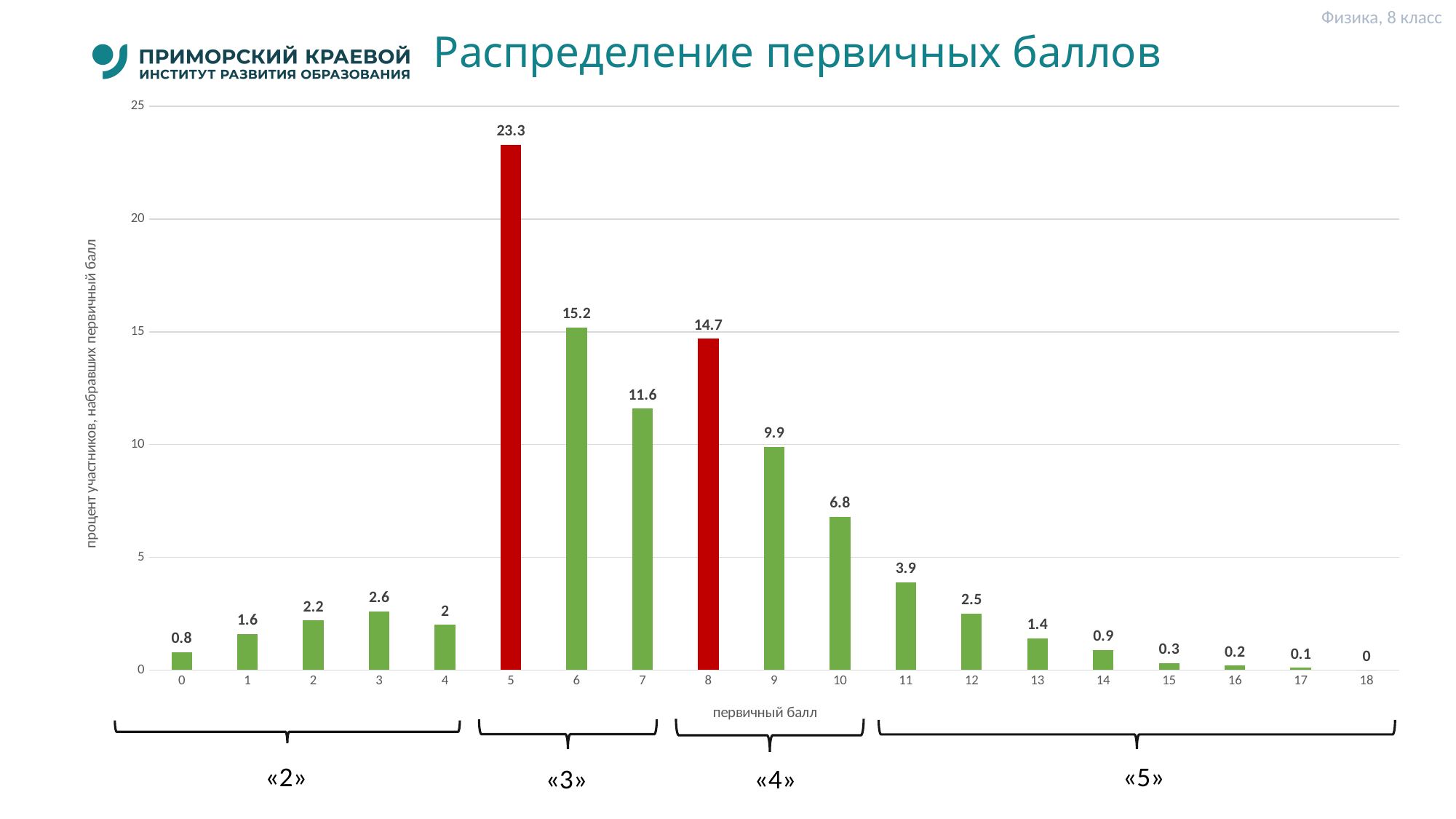
Which two bars are coloured red instead of green? primary scores 5 and 8 Is the value for primary score 9 greater or less than 10? less Which primary score has the highest percentage of participants? 5 Which primary score has the lowest percentage of participants? 18 Do the values rise or fall along the x axis from primary score 8 to primary score 18? fall What is the value for a primary score (первичный балл) of 5? 23.3 What is the difference between the values for primary scores 6 and 7? 3.6 How many primary score categories are shown on the x axis? 19 What is the value for a primary score of 8? 14.7 What is the value for a primary score of 11? 3.9 Which is larger: the value for primary score 8 or the value for primary score 6? primary score 6 What type of chart is shown on the slide? bar chart